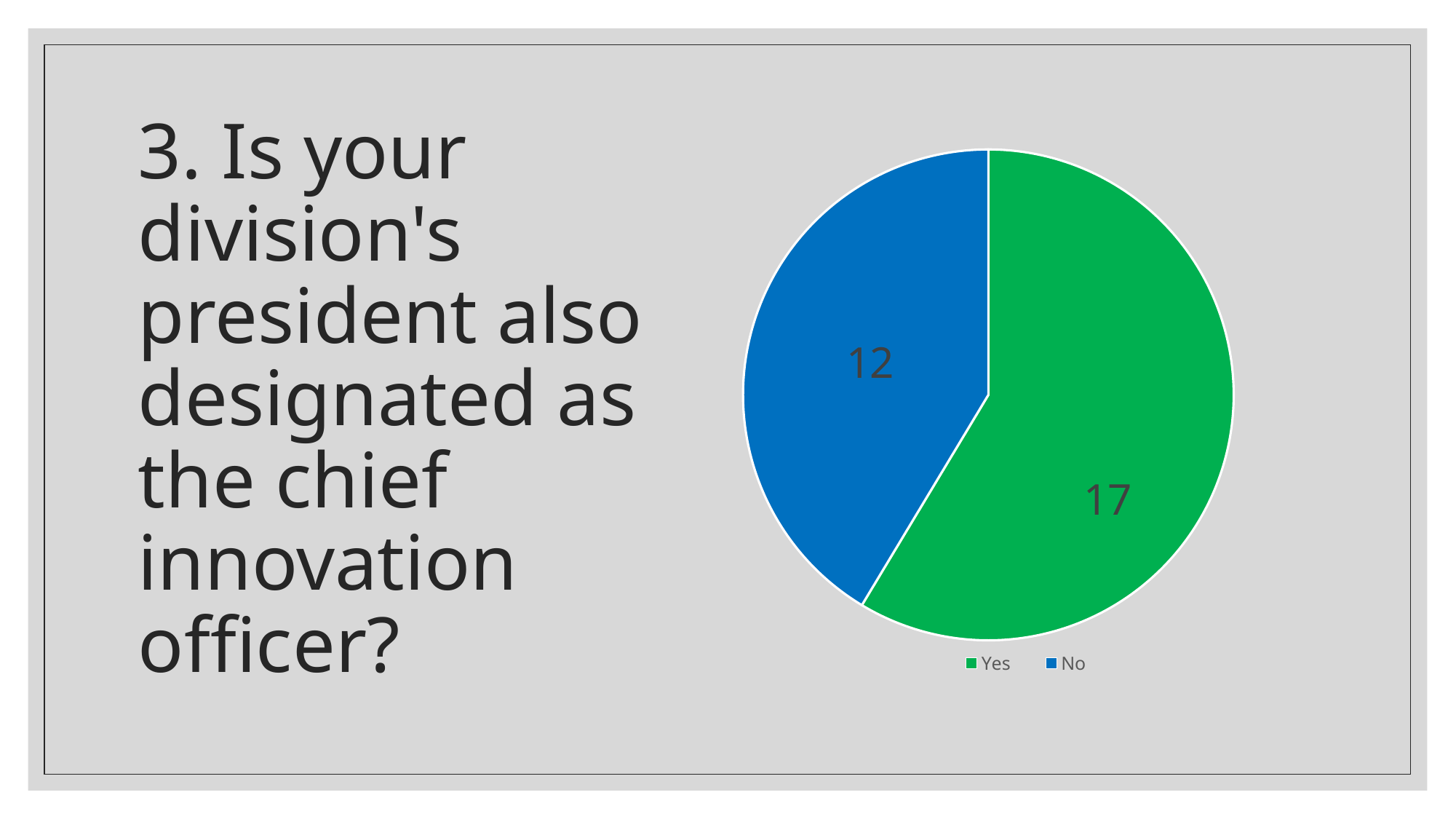
How many entries does the legend list? 2 Which is larger, the "Yes" slice or the "No" slice? Yes Which slice is the largest in the pie chart? Yes How many responses are labelled for the "No" slice? 12 What is the total of the values shown in the pie chart? 29 How many slices does the pie chart have? 2 What is the difference between the "Yes" and "No" values? 5 What colour is the "No" slice? Blue How many responses are labelled for the "Yes" slice? 17 What kind of chart is shown on the slide? Pie chart What colour is the "Yes" slice? Green Which slice is the smallest in the pie chart? No